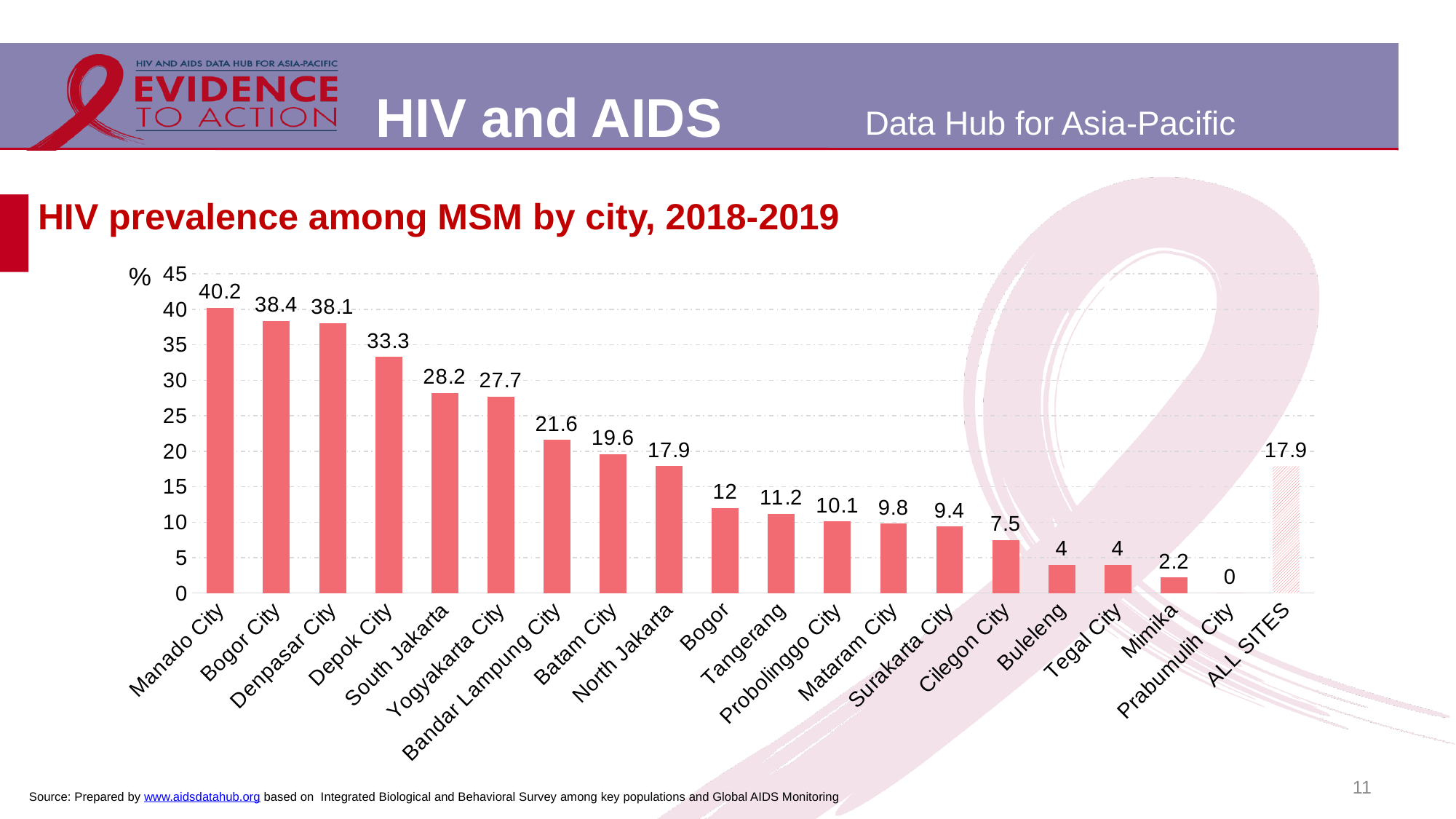
What is the value shown for Mimika? 2.2 What is the title of the chart? HIV prevalence among MSM by city, 2018-2019 What is the difference between the values for Bogor City and Bogor? 26.4 What kind of chart is shown on the slide? Bar chart What is the value shown for ALL SITES? 17.9 Which city has the lowest HIV prevalence among MSM? Prabumulih City Do the city values rise or fall from left to right across the chart (excluding ALL SITES)? Fall Which city has the highest HIV prevalence among MSM? Manado City Which has a higher HIV prevalence among MSM, South Jakarta or North Jakarta? South Jakarta How many bars are plotted on the chart, including ALL SITES? 20 What is the HIV prevalence among MSM in Manado City? 40.2 What is the HIV prevalence among MSM in Depok City? 33.3